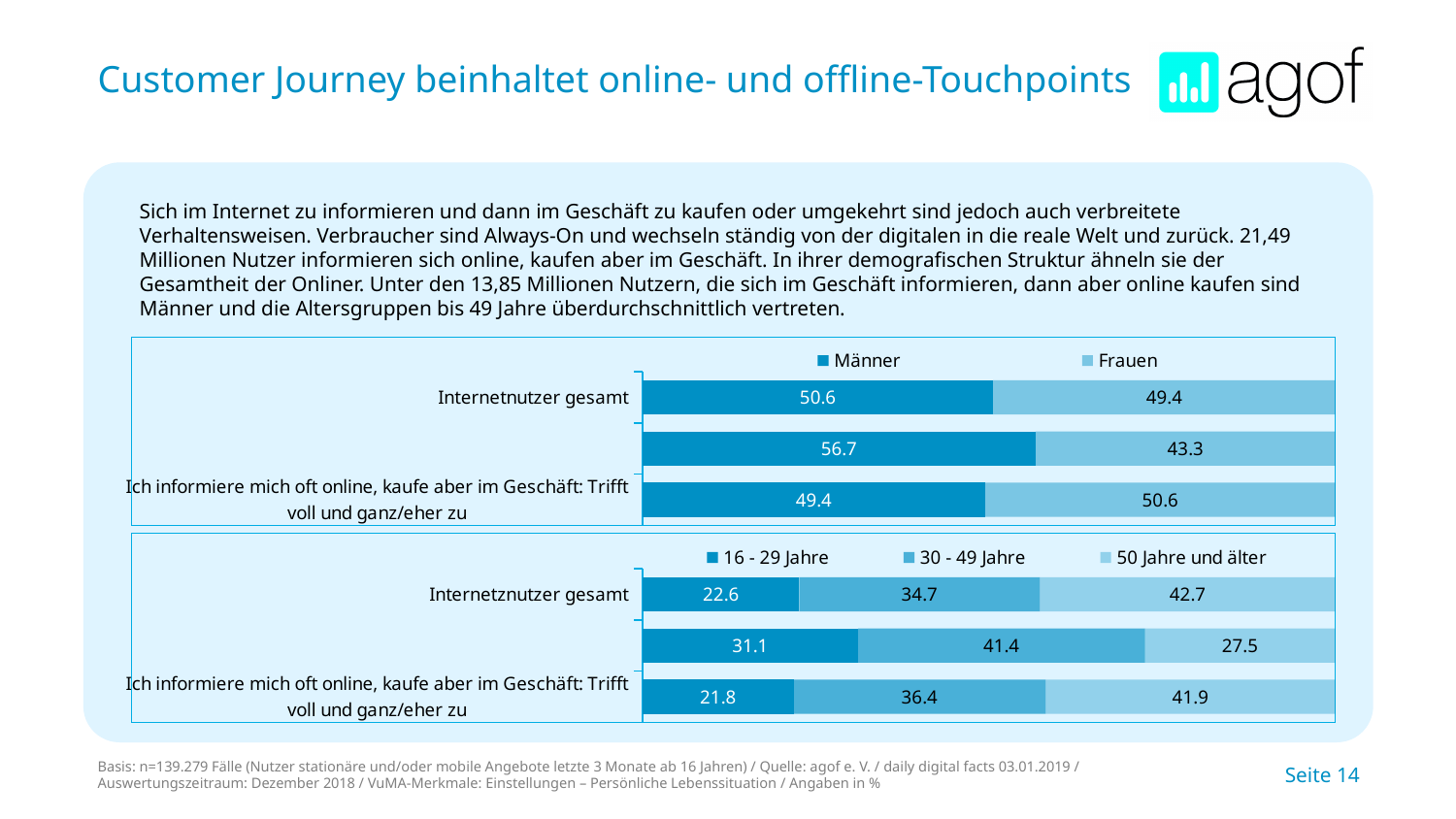
How many series does the legend of the bottom chart (age groups) list? 3 How many bars does the top chart (Männer/Frauen) contain? 3 In the top chart (Männer/Frauen), which is larger in the 'Internetnutzer gesamt' bar, Männer or Frauen? Männer In the top chart (Männer/Frauen), what is the value for Männer in the 'Internetnutzer gesamt' bar? 50.6 In the bottom chart (age groups), which age group has the smallest share in the bar 'Ich informiere mich oft online, kaufe aber im Geschäft: Trifft voll und ganz/eher zu'? 16 - 29 Jahre What kind of chart is the top chart (Männer/Frauen)? Bar chart In the bottom chart (age groups), which age group has the largest share in the 'Internetznutzer gesamt' bar? 50 Jahre und älter In the top chart (Männer/Frauen), what is the value for Frauen in the bar 'Ich informiere mich oft online, kaufe aber im Geschäft: Trifft voll und ganz/eher zu'? 50.6 How many series does the legend of the top chart list? 2 In the bottom chart (age groups), what is the difference between the '30 - 49 Jahre' value for 'Ich informiere mich oft online, kaufe aber im Geschäft: Trifft voll und ganz/eher zu' and the '30 - 49 Jahre' value for 'Internetznutzer gesamt'? 1.7 In the bottom chart (age groups), what is the value for '16 - 29 Jahre' in the bar 'Ich informiere mich oft online, kaufe aber im Geschäft: Trifft voll und ganz/eher zu'? 21.8 In the bottom chart (age groups), what is the value for '50 Jahre und älter' in the 'Internetznutzer gesamt' bar? 42.7